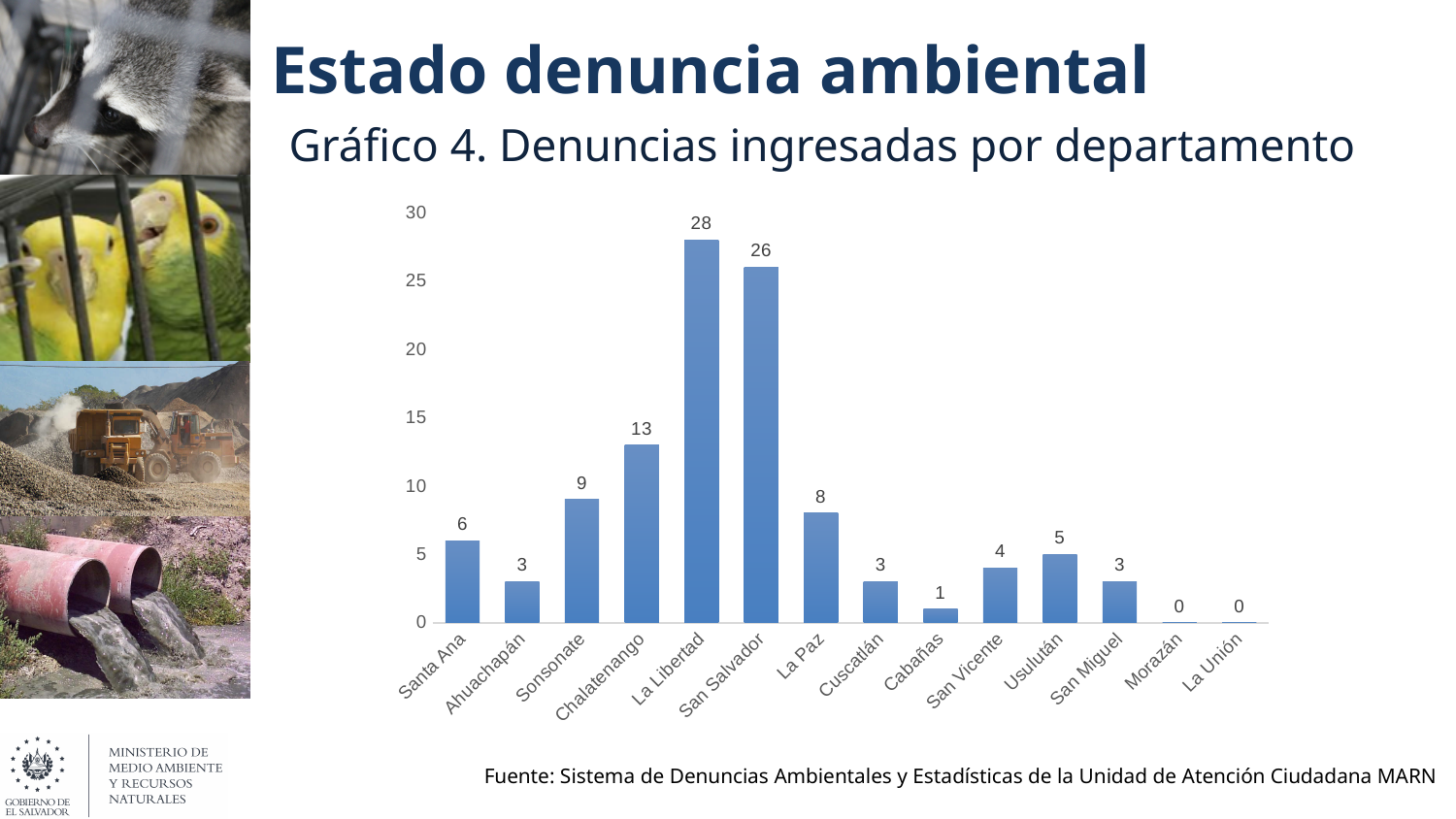
What is the difference between the values for La Libertad and San Salvador? 2 What is the value shown for Cabañas? 1 Which department has the highest number of complaints? La Libertad What is the title of the chart? Gráfico 4. Denuncias ingresadas por departamento Which has a larger value, San Vicente or Cuscatlán? San Vicente What is the value shown for Chalatenango? 13 What kind of chart is shown on the slide? Bar chart How many complaints were recorded for La Libertad? 28 Which has a larger value, La Paz or Usulután? La Paz What is the difference between the values for Sonsonate and Santa Ana? 3 How many departments are shown on the x axis? 14 How many departments have a value of 0? 2